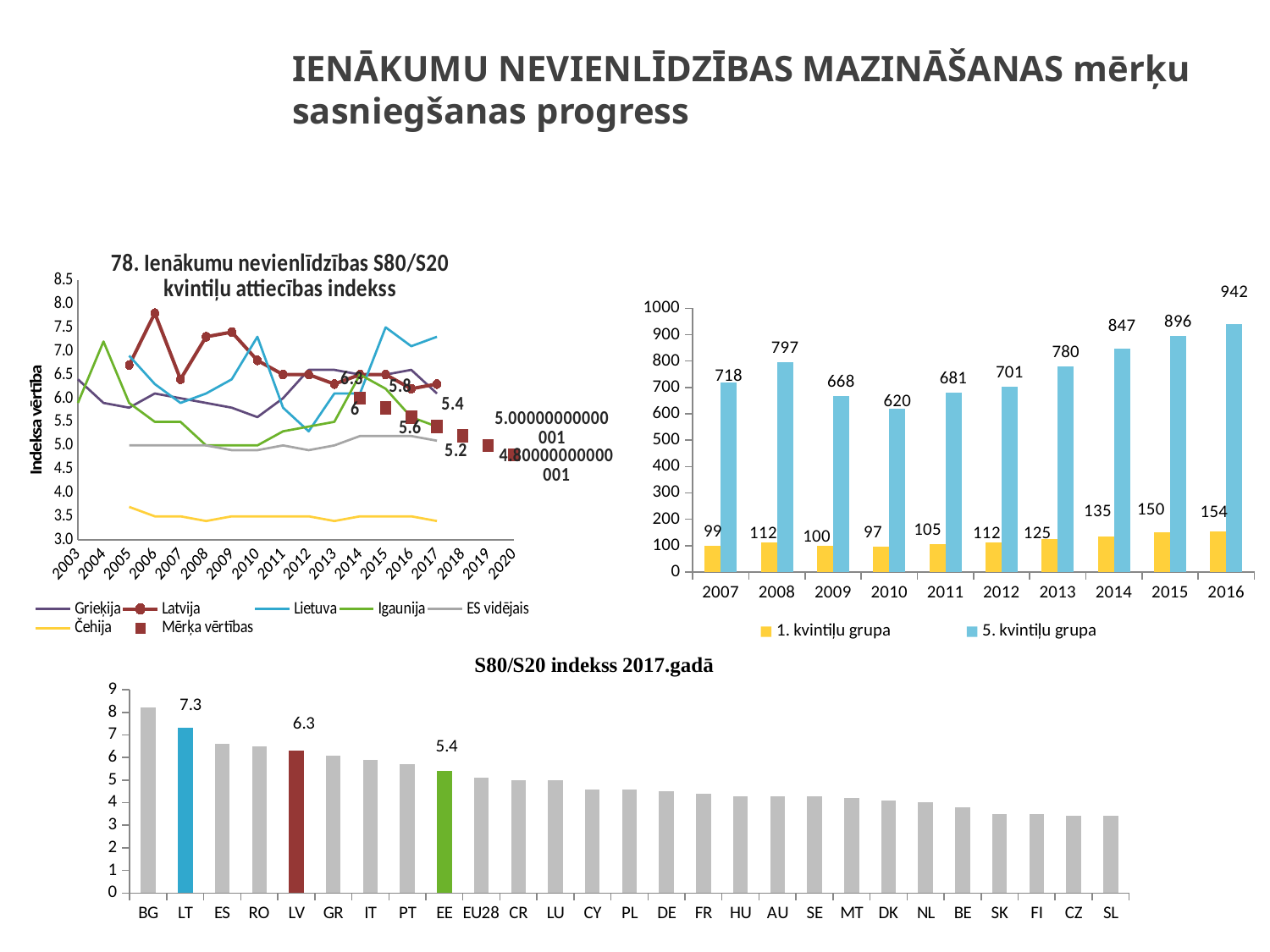
In the top-right bar chart, what is the value for the 1. kvintiļu grupa series in 2010? 97 In the top-right bar chart, what is the value for the 5. kvintiļu grupa series in 2016? 942 In the bottom chart titled 'S80/S20 indekss 2017.gadā', which country has the highest value? BG In the bottom chart titled 'S80/S20 indekss 2017.gadā', what is the difference between the values for LT and EE? 1.9 In the top-right bar chart, which year has the lowest value for the 5. kvintiļu grupa series? 2010 In the bottom chart titled 'S80/S20 indekss 2017.gadā', is the value for BG greater or less than 8? greater In the top-right bar chart, how many series does the legend list? 2 In the bottom chart titled 'S80/S20 indekss 2017.gadā', what is the value for LV? 6.3 In the top-right bar chart, which year has the highest value for the 1. kvintiļu grupa series? 2016 In the top-right bar chart, how many years are shown on the x axis? 10 What kind of chart is the top-left chart titled '78. Ienākumu nevienlīdzības S80/S20 kvintiļu attiecības indekss'? line chart In the top-right bar chart, what is the difference between the 5. kvintiļu grupa values for 2016 and 2015? 46